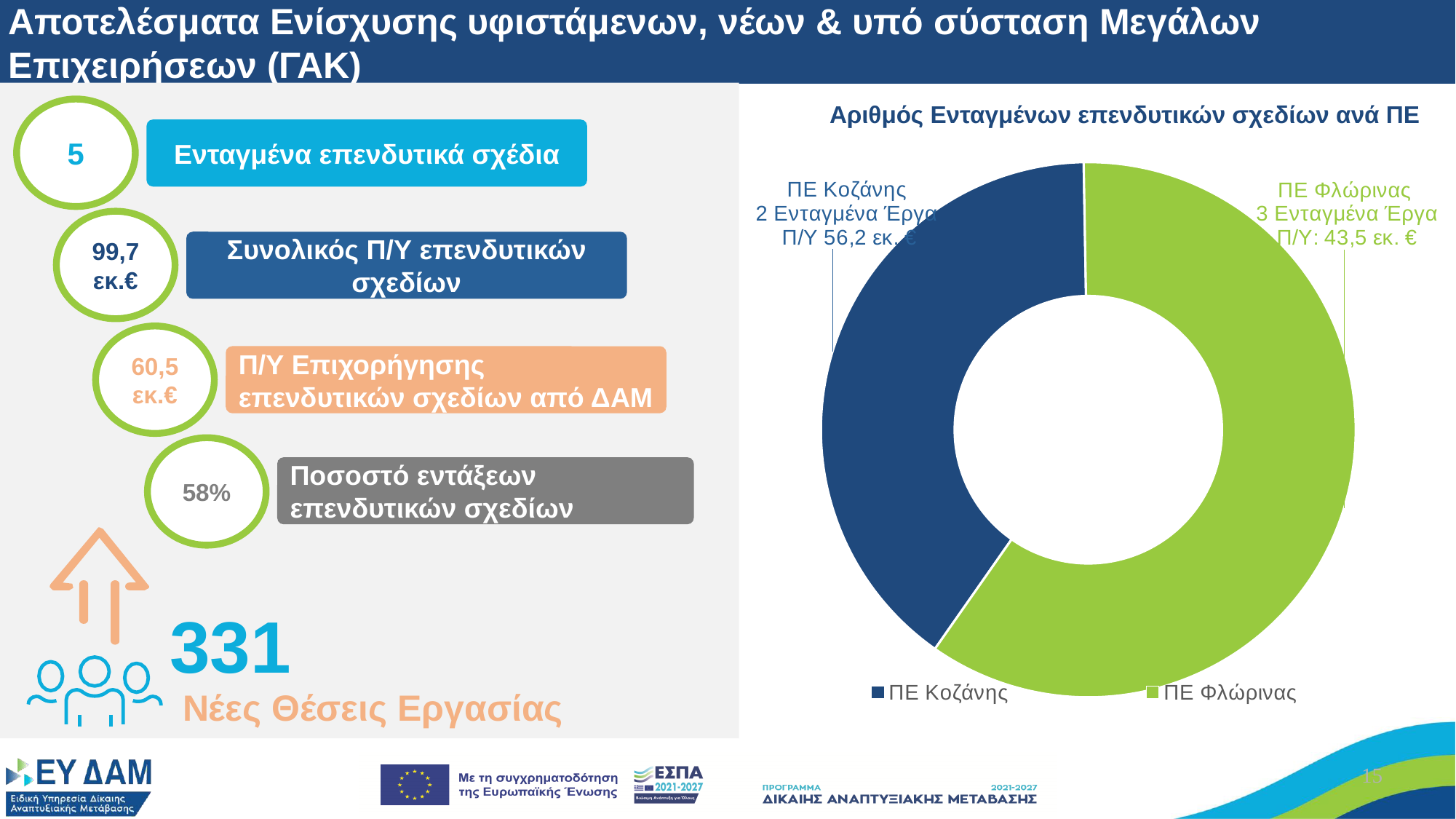
What budget (Π/Υ) is shown on the chart for ΠΕ Κοζάνης? 56,2 εκ. € Which regional unit has the smaller number of approved projects in the chart? ΠΕ Κοζάνης How many approved projects (Ενταγμένα Έργα) does the chart show for ΠΕ Φλώρινας? 3 What is the difference in the number of approved projects between ΠΕ Φλώρινας and ΠΕ Κοζάνης? 1 What kind of chart is shown on the right side of the slide? doughnut chart How many slices does the doughnut chart have? 2 How many entries does the chart legend list? 2 What budget (Π/Υ) is shown on the chart for ΠΕ Φλώρινας? 43,5 εκ. € How many approved projects (Ενταγμένα Έργα) does the chart show for ΠΕ Κοζάνης? 2 Which regional unit has the larger number of approved projects in the chart? ΠΕ Φλώρινας What share of the total approved projects in the chart belongs to ΠΕ Φλώρινας? 60% What is the title of the chart on the slide? Αριθμός Ενταγμένων επενδυτικών σχεδίων ανά ΠΕ